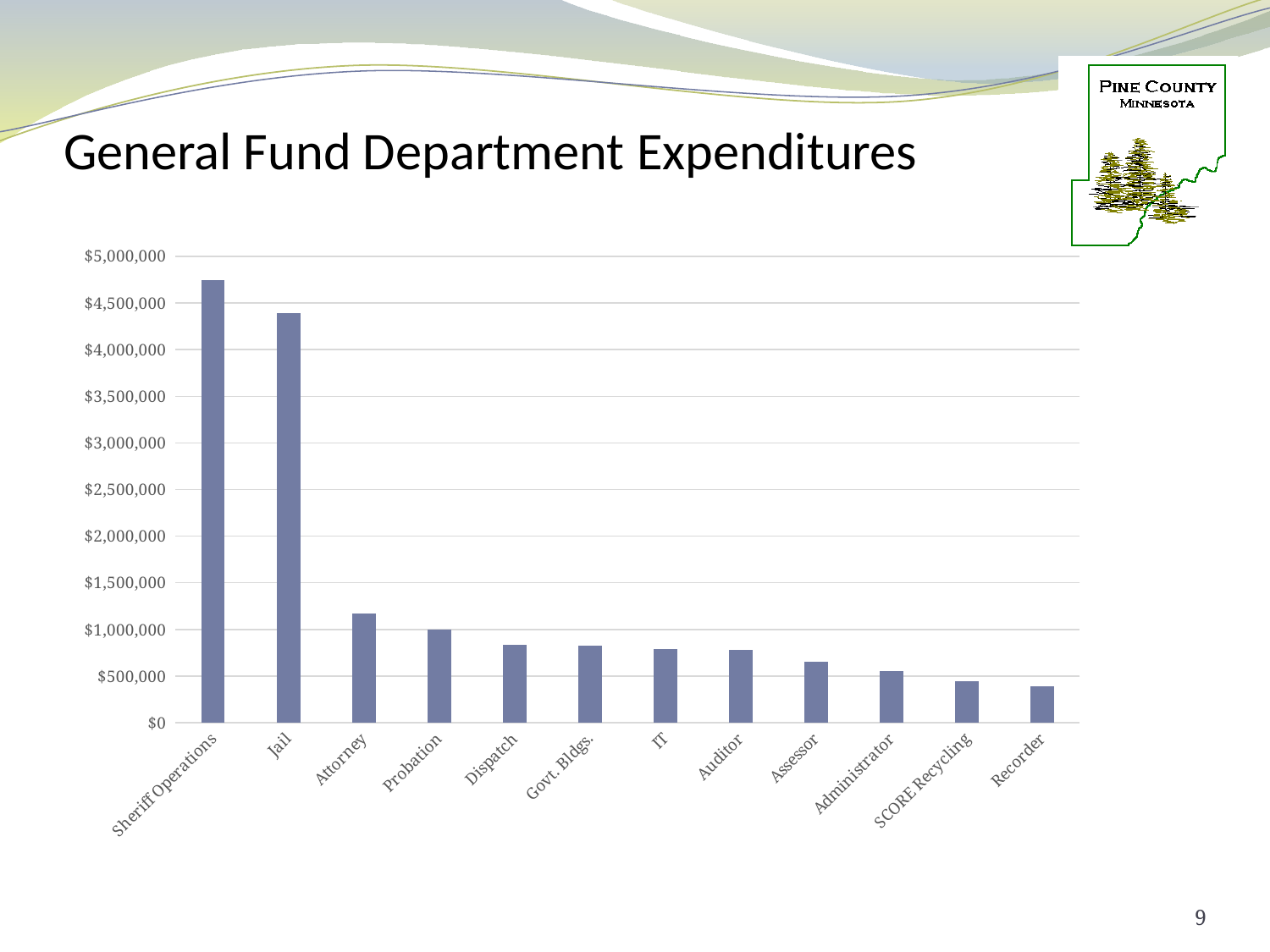
Which department has the lowest expenditure in the chart? Recorder Which has the larger expenditure, Attorney or Probation? Attorney Is the value for Sheriff Operations greater or less than $4,500,000? greater How many departments are shown on the x axis of the chart? 12 Is the value for Jail greater or less than $4,500,000? less Is the value for Recorder greater or less than $500,000? less Which department has the highest expenditure in the chart? Sheriff Operations What kind of chart is shown on the slide? bar chart Which has the larger expenditure, Sheriff Operations or Jail? Sheriff Operations What is the title of the slide containing the chart? General Fund Department Expenditures Do the bar values rise or fall moving from left to right along the x axis? fall